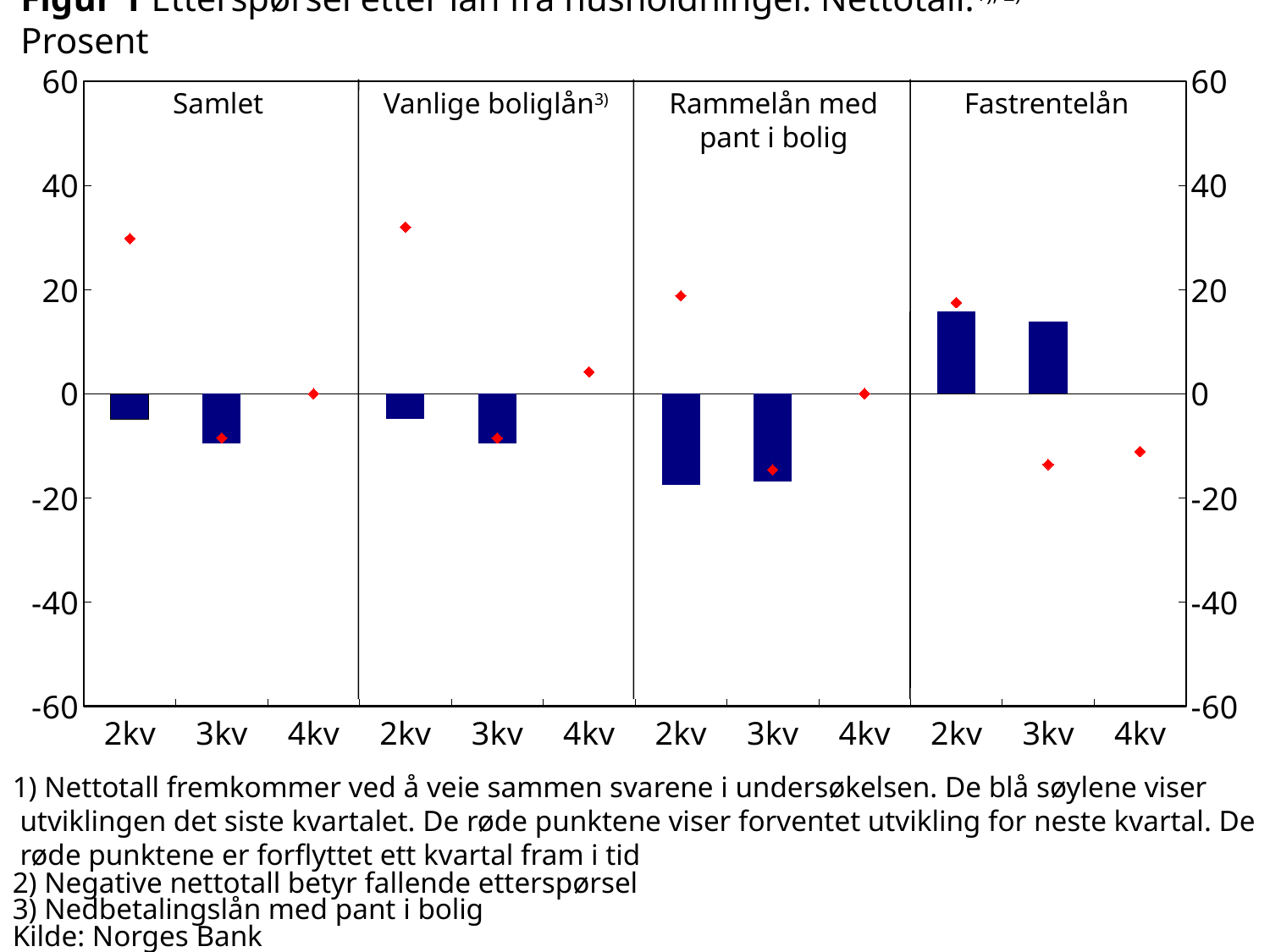
How many quarters are labelled on the x axis of each panel? 3 In the Samlet panel, which quarter has the lower blue bar, 2kv or 3kv? 3kv In the Rammelån med pant i bolig panel, is the blue bar for 2kv greater or less than 0? less In the Vanlige boliglån panel, do the blue bars rise or fall from 2kv to 3kv? fall How many panels (loan categories) does the chart have? 4 In the Samlet panel, is the red point for 2kv greater or less than 20? greater According to the footnote, what do the red points show? Forventet utvikling for neste kvartal Which panel contains the lowest blue bar in the chart? Rammelån med pant i bolig In the Vanlige boliglån panel, is the red point for 2kv greater or less than 40? less What kind of chart is shown on the slide? bar chart Which panel is the only one with positive blue bars? Fastrentelån